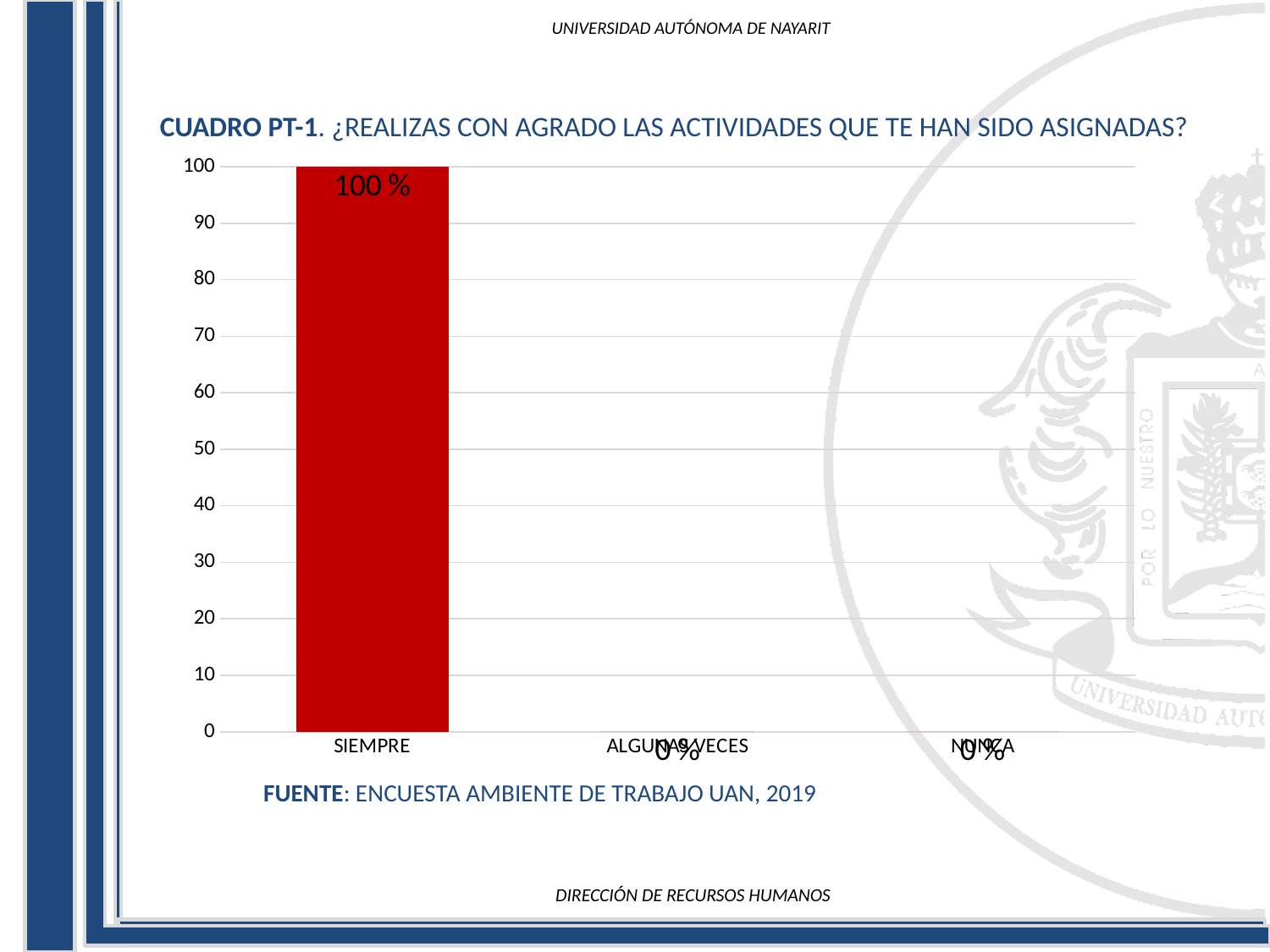
What is the value for NUNCA? 0 % What colour is the bar for SIEMPRE? red What kind of chart is shown on the slide? bar chart Which is larger, the value for SIEMPRE or the value for ALGUNAS VECES? SIEMPRE What is the value for SIEMPRE? 100 % What is the value for ALGUNAS VECES? 0 % Which category has the highest value? SIEMPRE What is the difference between the values for SIEMPRE and NUNCA? 100 % Is the value for SIEMPRE greater or less than 50? greater Do the values rise or fall from SIEMPRE to NUNCA along the x axis? fall What is the source cited below the chart? ENCUESTA AMBIENTE DE TRABAJO UAN, 2019 How many categories are shown on the x axis? 3